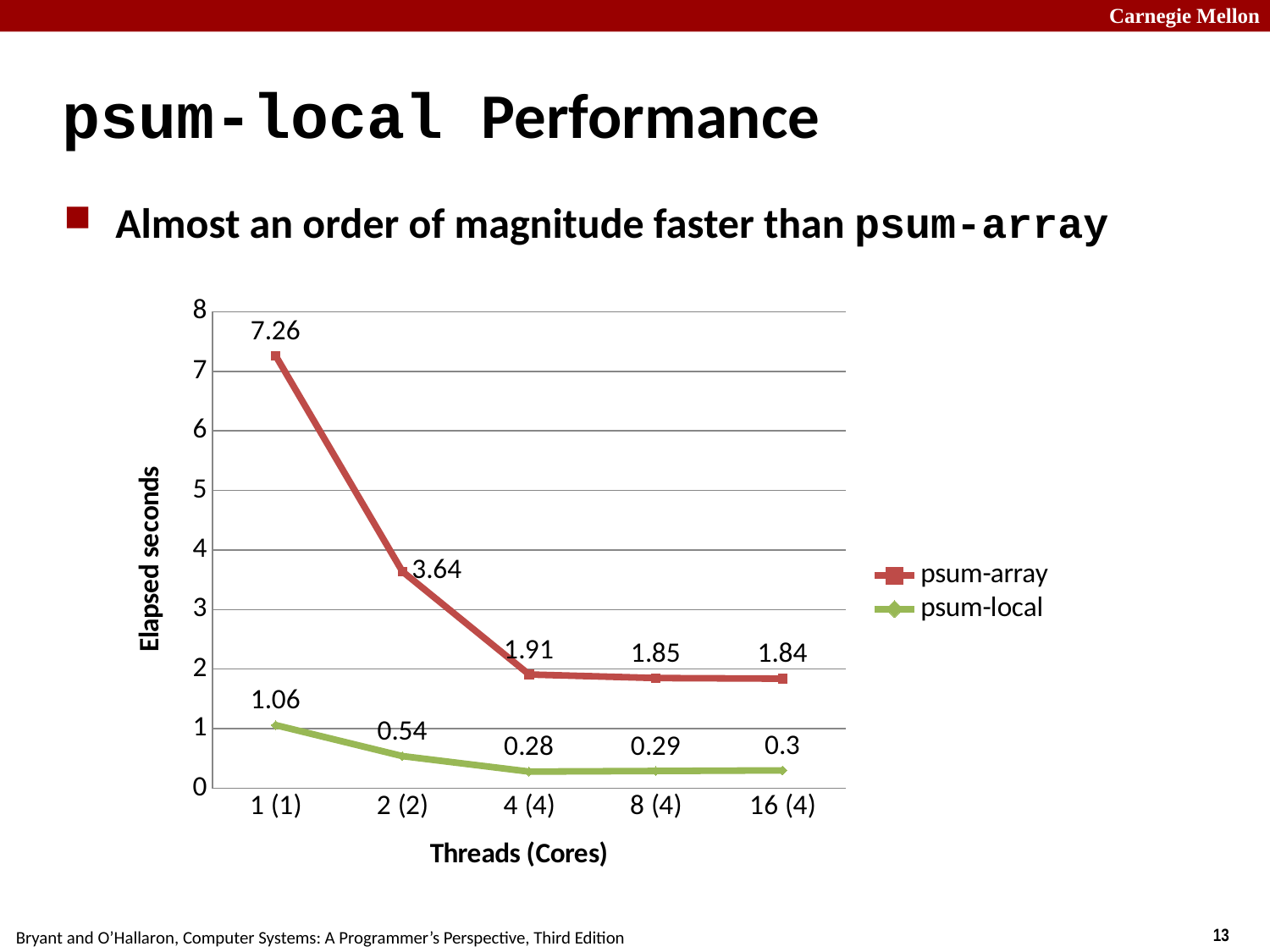
At which threads (cores) setting does psum-local have its lowest elapsed seconds? 4 (4) What is the label of the y axis? Elapsed seconds What kind of chart is shown on the slide? line chart What is the elapsed seconds value for psum-array at 16 (4) threads (cores)? 1.84 What is the elapsed seconds value for psum-array at 1 (1) threads (cores)? 7.26 At which threads (cores) setting does psum-array have its highest elapsed seconds? 1 (1) Does the elapsed seconds for psum-array rise or fall from 1 (1) to 4 (4) threads (cores)? fall Which series has the larger elapsed seconds at 8 (4) threads (cores), psum-array or psum-local? psum-array How many series does the legend list? 2 What is the difference in elapsed seconds between psum-array and psum-local at 2 (2) threads (cores)? 3.1 How many threads (cores) settings are plotted on the x axis? 5 What is the elapsed seconds value for psum-local at 4 (4) threads (cores)? 0.28